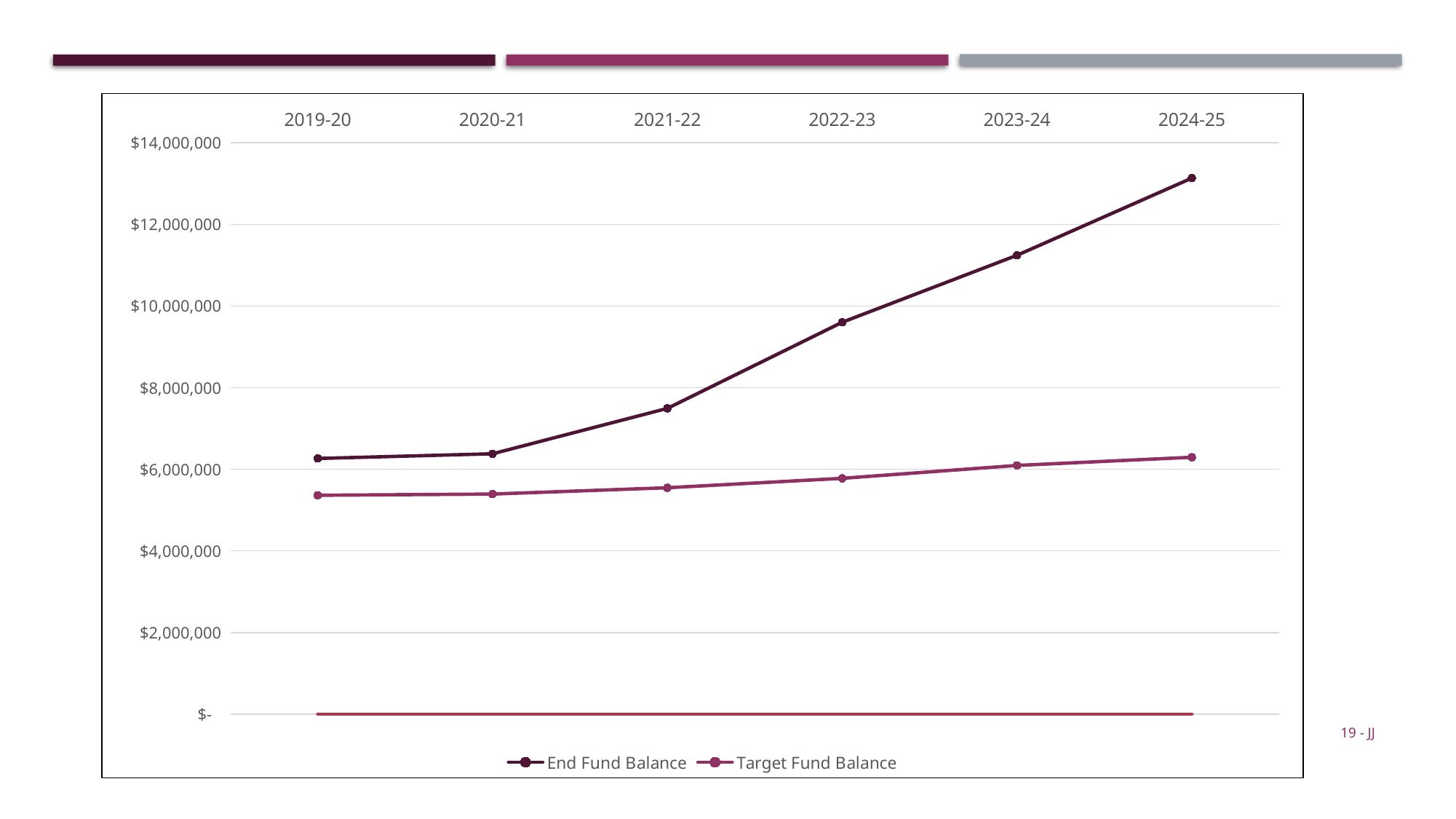
Is the End Fund Balance for 2022-23 greater or less than $10,000,000? less How many fiscal years are plotted along the x axis? 6 In which year is the End Fund Balance highest? 2024-25 Is the Target Fund Balance for 2019-20 greater or less than $6,000,000? less Does the End Fund Balance rise or fall from 2019-20 to 2024-25? rise How many series does the legend list? 2 Which is larger in 2024-25, the End Fund Balance or the Target Fund Balance? End Fund Balance What kind of chart is shown on the slide? line chart In which year is the Target Fund Balance highest? 2024-25 In which year is the End Fund Balance lowest? 2019-20 What are the two series named in the legend? End Fund Balance and Target Fund Balance Is the End Fund Balance for 2024-25 greater or less than $12,000,000? greater